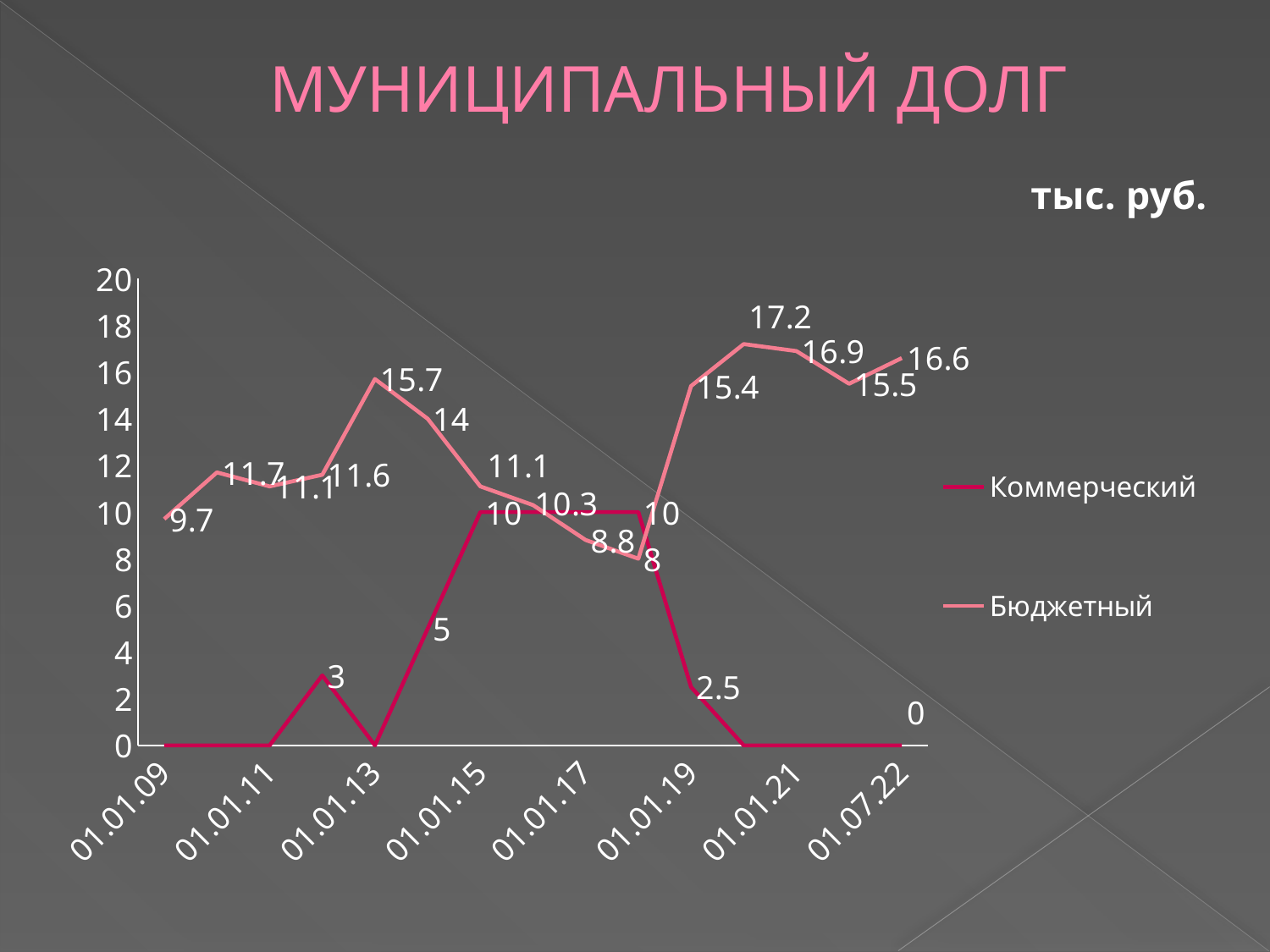
What unit is indicated for the values on the chart? тыс. руб. What type of chart is shown on the slide? line chart What is the lowest value reached by the Бюджетный series? 8 How many series does the legend list? 2 What is the value of the Бюджетный series at 01.01.17? 8.8 At 01.01.15, which series has the larger value, Коммерческий or Бюджетный? Бюджетный What is the value of the Коммерческий series at 01.01.19? 2.5 What is the difference between the Бюджетный values at 01.01.19 and 01.01.17? 6.6 What is the value of the Бюджетный series at 01.01.09? 9.7 What is the highest value reached by the Бюджетный series? 17.2 What is the value of the Коммерческий series at 01.07.22? 0 What is the value of the Бюджетный series at 01.01.13? 15.7